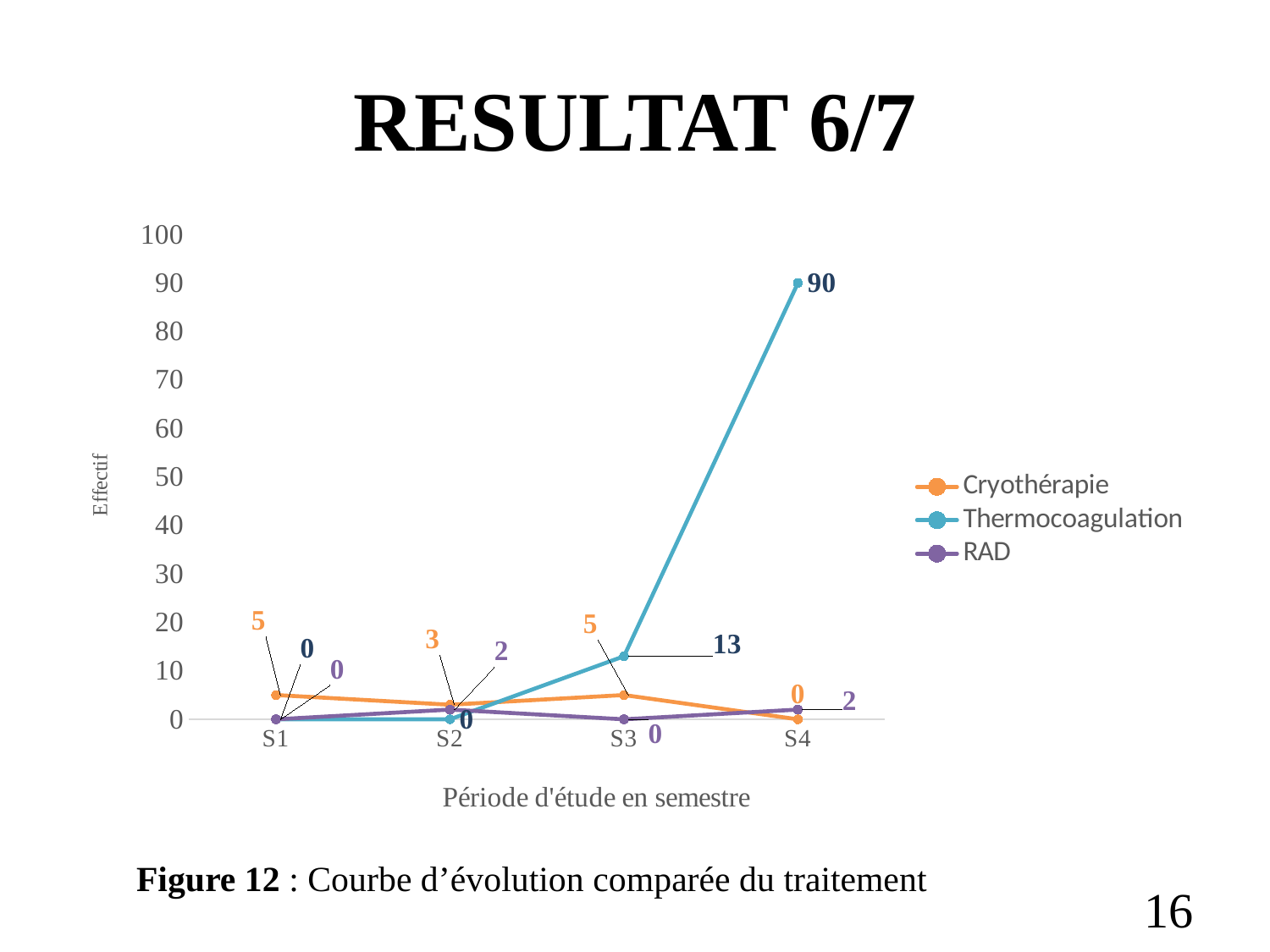
How many periods are shown on the x axis? 4 What is the value for Thermocoagulation at S3? 13 In which period does Cryothérapie have its lowest value? S4 In which period does Thermocoagulation reach its highest value? S4 Does the Thermocoagulation series rise or fall from S2 to S4? Rises How many series does the legend list? 3 What is the value for Cryothérapie at S2? 3 What is the value for RAD at S4? 2 What is the value for Thermocoagulation at S4? 90 At S3, which is larger: Cryothérapie or Thermocoagulation? Thermocoagulation What is the difference between the Thermocoagulation values at S4 and S3? 77 What kind of chart is shown on the slide? Line chart